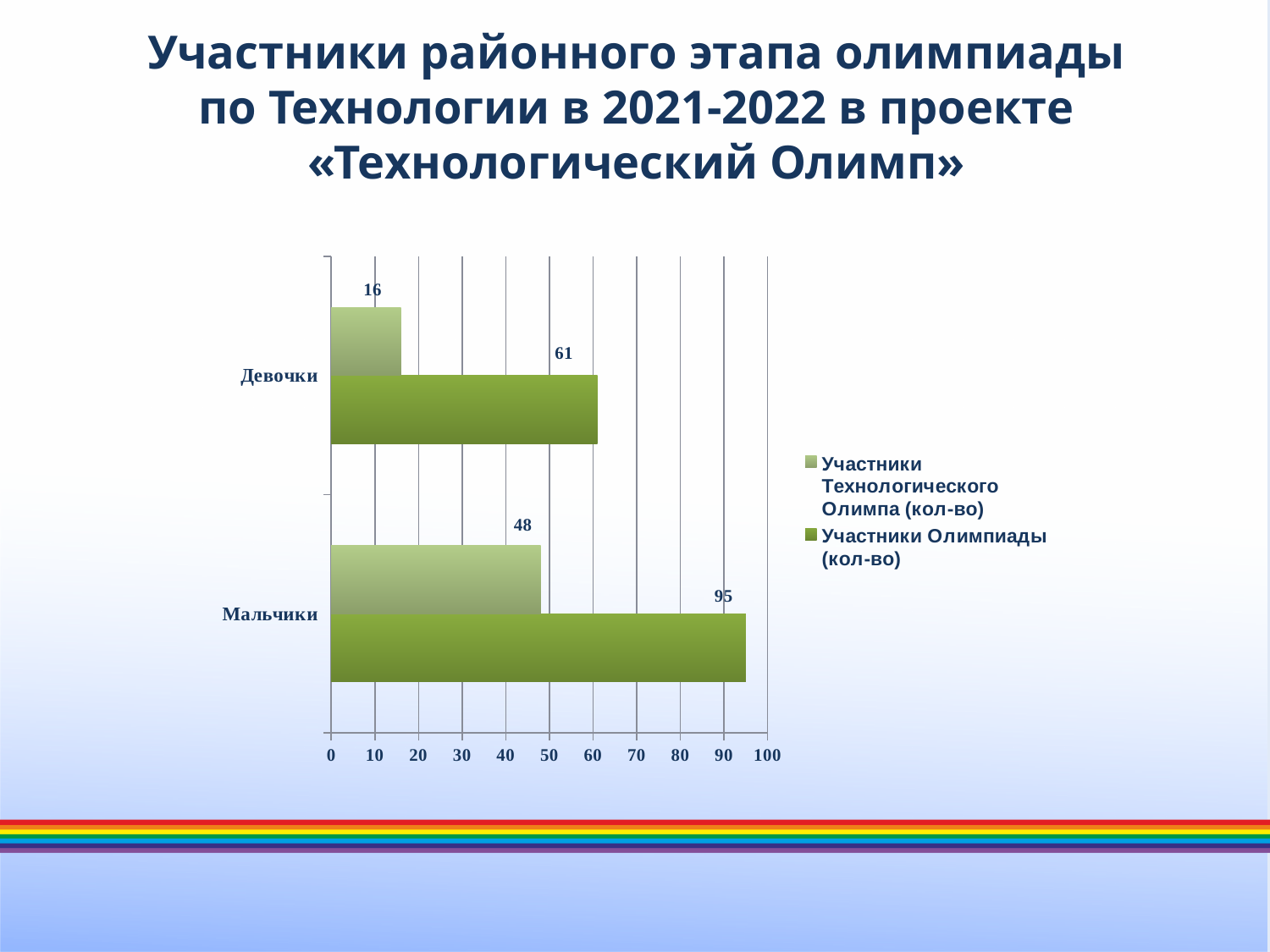
What is the value for Девочки in the series Участники Олимпиады (кол-во)? 61 What is the difference between the Участники Олимпиады (кол-во) values for Мальчики and Девочки? 34 How many series does the legend list? 2 How many categories are shown on the chart? 2 What is the value for Мальчики in the series Участники Технологического Олимпа (кол-во)? 48 What is the value for Мальчики in the series Участники Олимпиады (кол-во)? 95 What is the difference between the Участники Технологического Олимпа (кол-во) values for Мальчики and Девочки? 32 Which is larger for Девочки: Участники Технологического Олимпа (кол-во) or Участники Олимпиады (кол-во)? Участники Олимпиады (кол-во) Which category has the lowest value in the series Участники Технологического Олимпа (кол-во)? Девочки Which category has the highest value in the series Участники Олимпиады (кол-во)? Мальчики What kind of chart is shown on the slide? Bar chart What is the value for Девочки in the series Участники Технологического Олимпа (кол-во)? 16